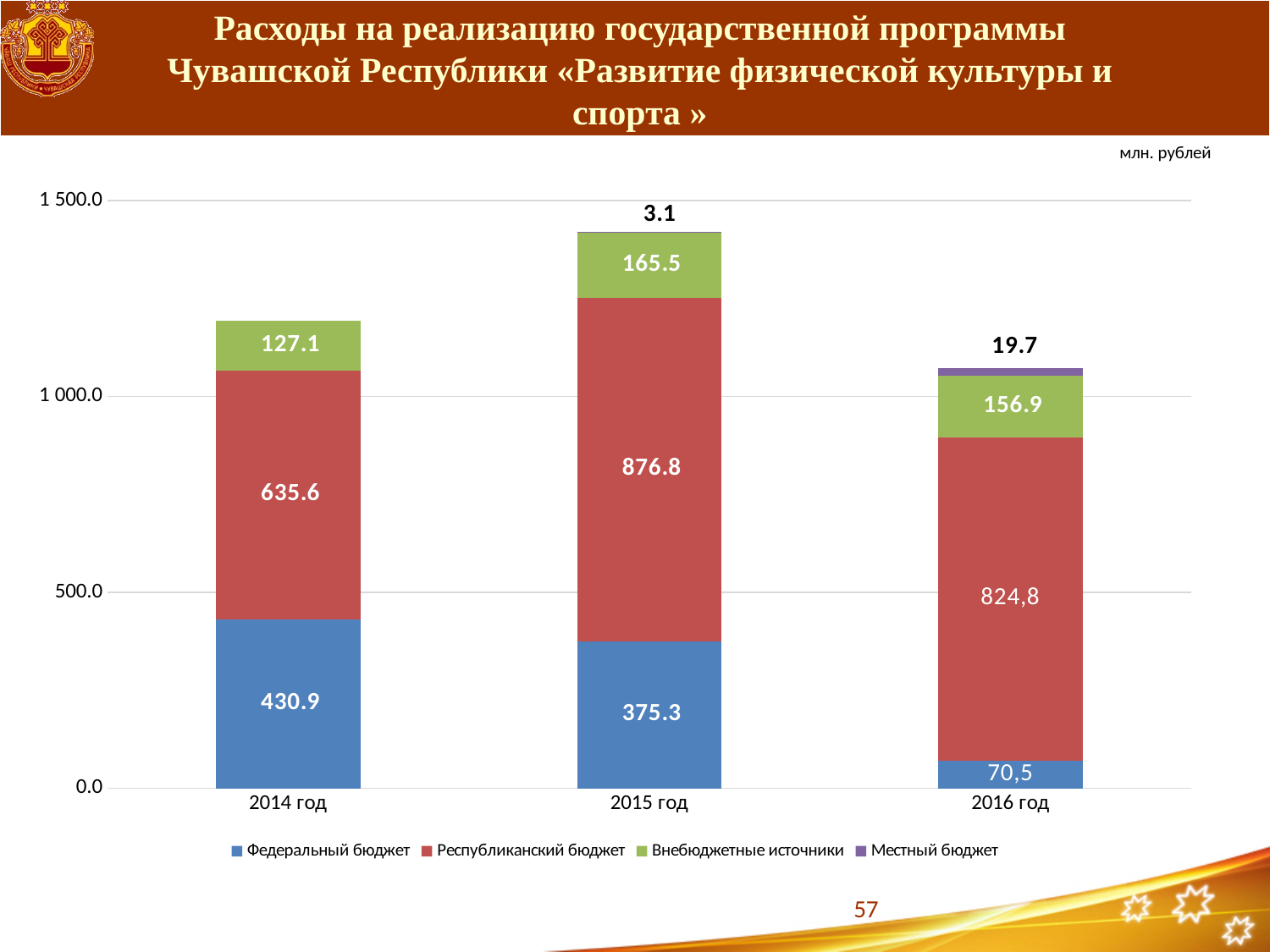
In which year is the Республиканский бюджет value the highest? 2015 год What is the value of Местный бюджет for 2016 год? 19.7 What type of chart is shown on the slide? stacked bar chart What is the value of Федеральный бюджет for 2016 год? 70,5 What is the value of Федеральный бюджет for 2014 год? 430.9 Which is larger: Внебюджетные источники in 2015 год or in 2014 год? 2015 год What is the value of Внебюджетные источники for 2016 год? 156.9 By how much does Федеральный бюджет in 2014 год exceed Федеральный бюджет in 2015 год? 55.6 What is the value of Республиканский бюджет for 2015 год? 876.8 In which year is the Федеральный бюджет value the lowest? 2016 год How many years (categories) are shown on the x axis? 3 How many series does the legend list? 4